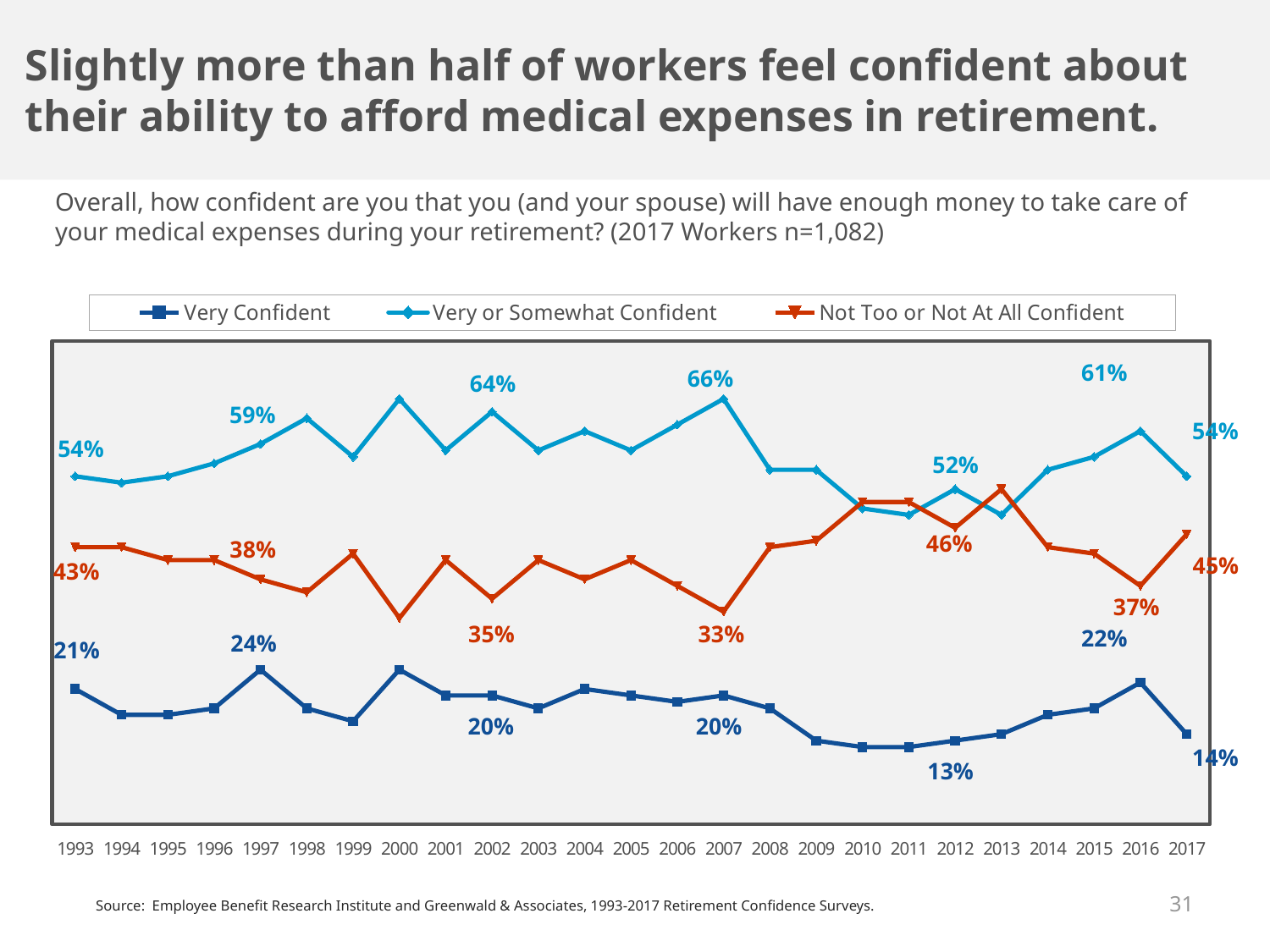
What type of chart is shown on the slide? line chart What is the value for Very or Somewhat Confident in 2016? 61% What is the value for Very Confident in 2012? 13% In 2012, which is larger: Very or Somewhat Confident or Not Too or Not At All Confident? Very or Somewhat Confident What is the value for Very Confident in 2017? 14% How many series does the legend list? 3 How many years are plotted along the x axis? 25 What is the value for Very or Somewhat Confident in 2017? 54% What is the value for Not Too or Not At All Confident in 2007? 33% Does the Very Confident series rise or fall from 2016 to 2017? fall What is the difference between Very or Somewhat Confident and Not Too or Not At All Confident in 2007? 33 percentage points